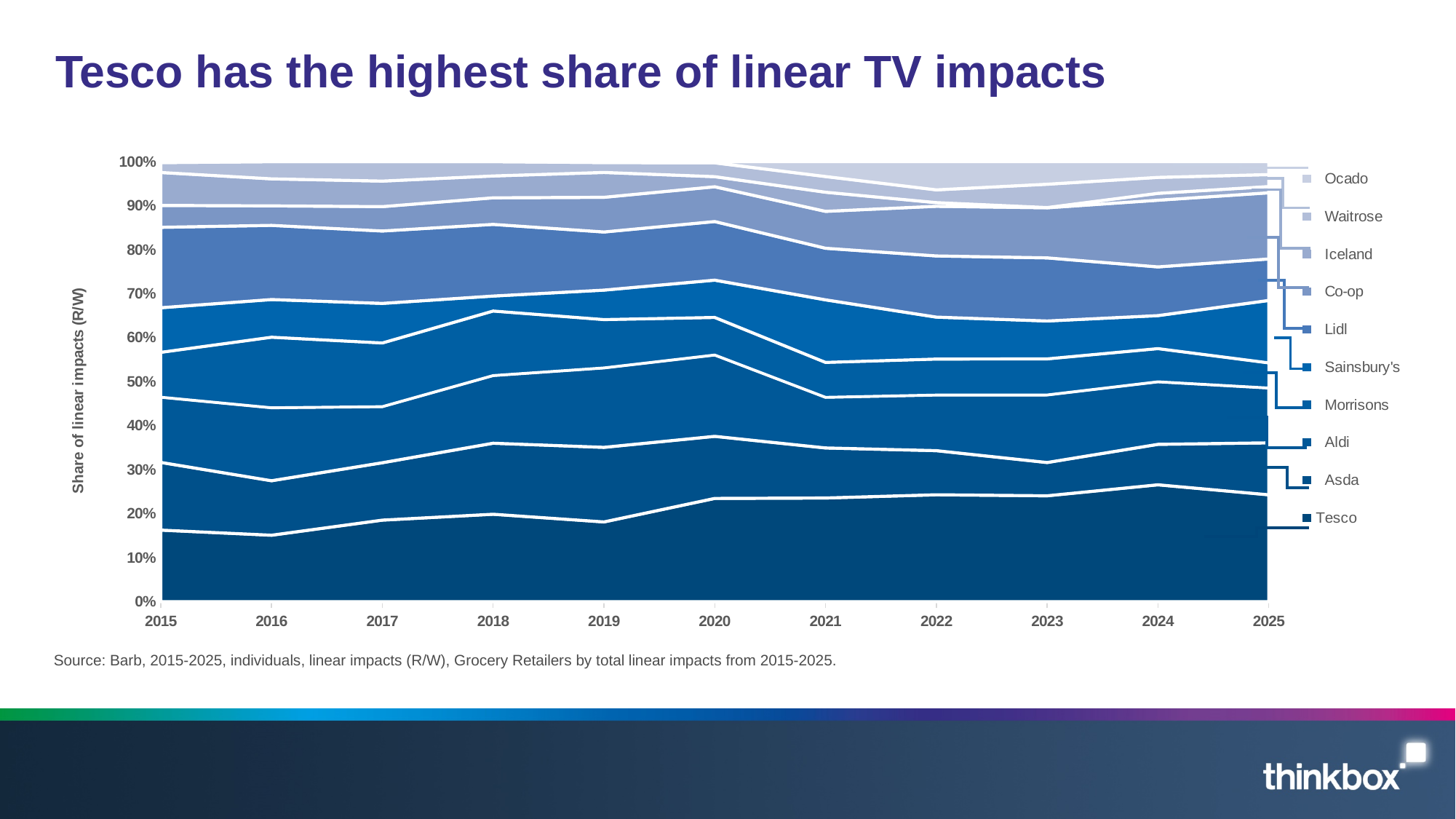
Does Tesco's share of linear impacts rise or fall between 2015 and 2025? rise What kind of chart is shown on the slide? Stacked area chart Which year is the first shown on the x axis? 2015 How many retailers does the legend list? 10 Is Tesco's share of linear impacts in 2016 greater or less than 20%? less Is Tesco's share of linear impacts in 2025 greater or less than 20%? greater How many years are shown along the x axis? 11 Is Tesco's share of linear impacts in 2015 greater or less than 20%? less What is the label on the y axis? Share of linear impacts (R/W) Which retailer has the highest share of linear TV impacts in 2025? Tesco Which is larger in 2025, Tesco's share or Morrisons' share? Tesco What is the title of the slide? Tesco has the highest share of linear TV impacts